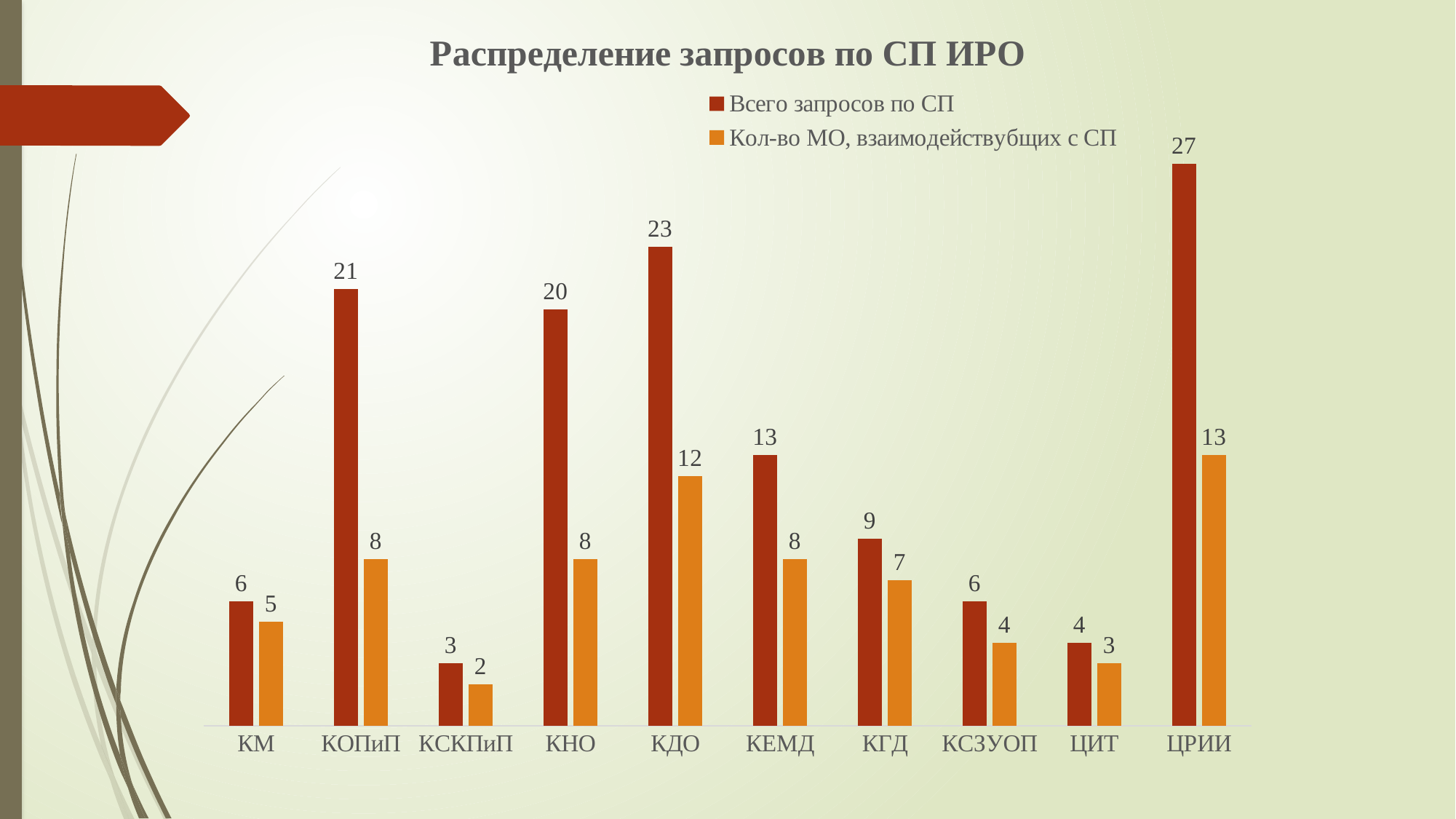
How many series does the legend list? 2 What is the title of the chart? Распределение запросов по СП ИРО What is the value of "Всего запросов по СП" for КДО? 23 How many categories are shown on the x axis? 10 What is the value of "Всего запросов по СП" for ЦИТ? 4 What is the value of "Кол-во МО, взаимодействубщих с СП" for КОПиП? 8 Which category has the lowest value for "Кол-во МО, взаимодействубщих с СП"? КСКПиП What is the difference between "Всего запросов по СП" for КДО and for КЕМД? 10 What is the difference between "Всего запросов по СП" and "Кол-во МО, взаимодействубщих с СП" for ЦРИИ? 14 What kind of chart is shown on the slide? Bar chart Which is larger: "Всего запросов по СП" for КОПиП or for КНО? КОПиП Which category has the highest value for "Всего запросов по СП"? ЦРИИ